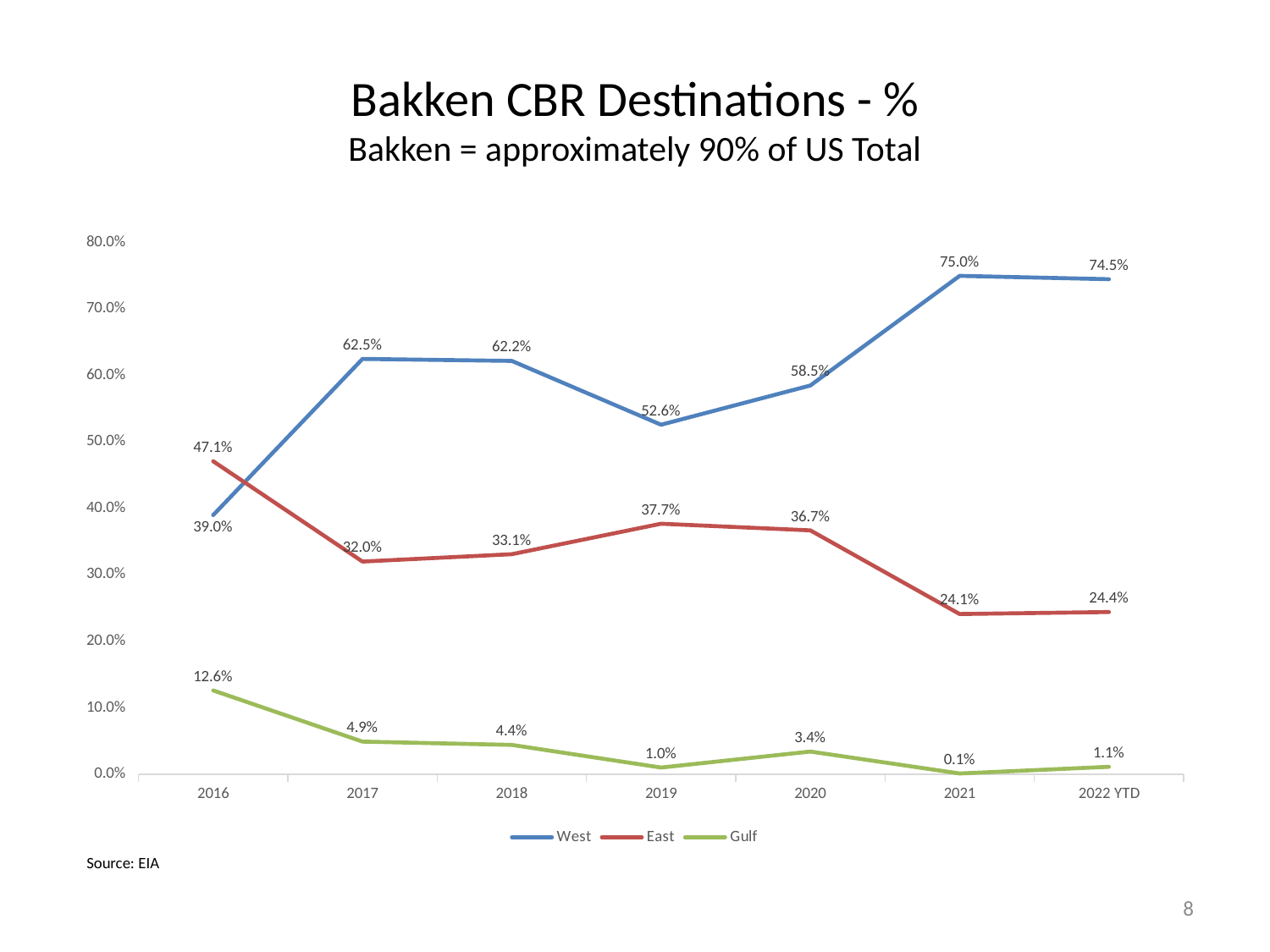
What is the value for East in 2016? 47.1% What is the value for West in 2021? 75.0% What is the value for Gulf in 2019? 1.0% How many years are shown on the x axis? 7 Does the East series rise or fall from 2020 to 2021? fall In which year is the Gulf series at its highest? 2016 Is the value for East in 2020 greater or less than 30.0%? greater What is the difference between the West and East values in 2022 YTD? 50.1% In which year is the West series at its lowest? 2016 What kind of chart is this? line chart How many series does the legend list? 3 Which series has the larger value in 2016, West or East? East